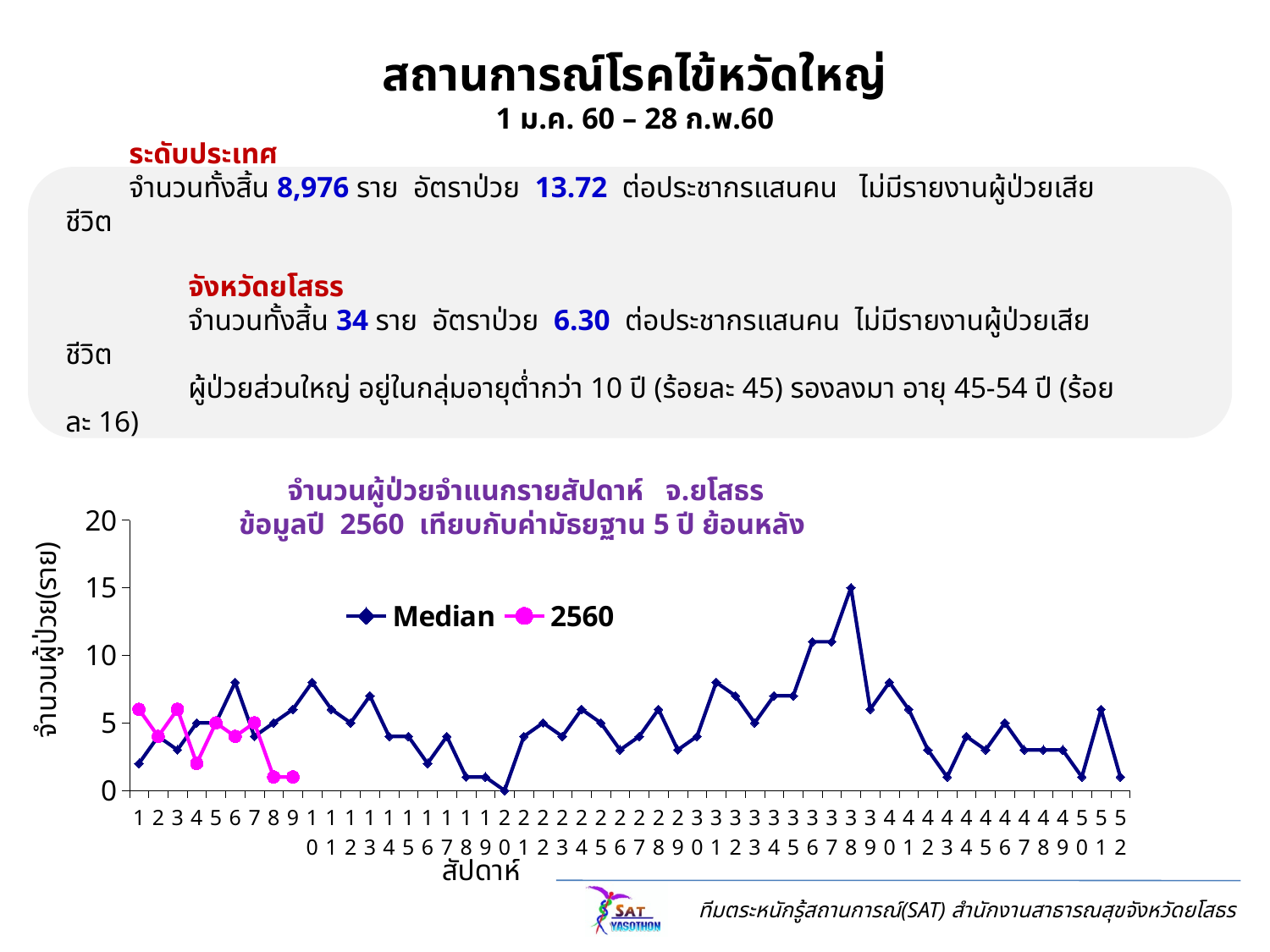
Does the 2560 series rise or fall from week 7 to week 9? fall Is the Median value at week 38 greater or less than 10? greater What are the two series named in the chart legend? Median and 2560 How many series does the chart legend list? 2 What colour is the 2560 series line in the chart? magenta (pink) Which is larger: the 2560 value at week 1 or the 2560 value at week 9? week 1 How many weekly data points does the 2560 series have? 9 Is the 2560 value at week 8 greater or less than 5? less At which week does the Median series reach its highest value? week 38 At which week does the Median series reach its lowest value? week 20 What kind of chart is shown on the slide? line chart What is the Median value at week 38? 15